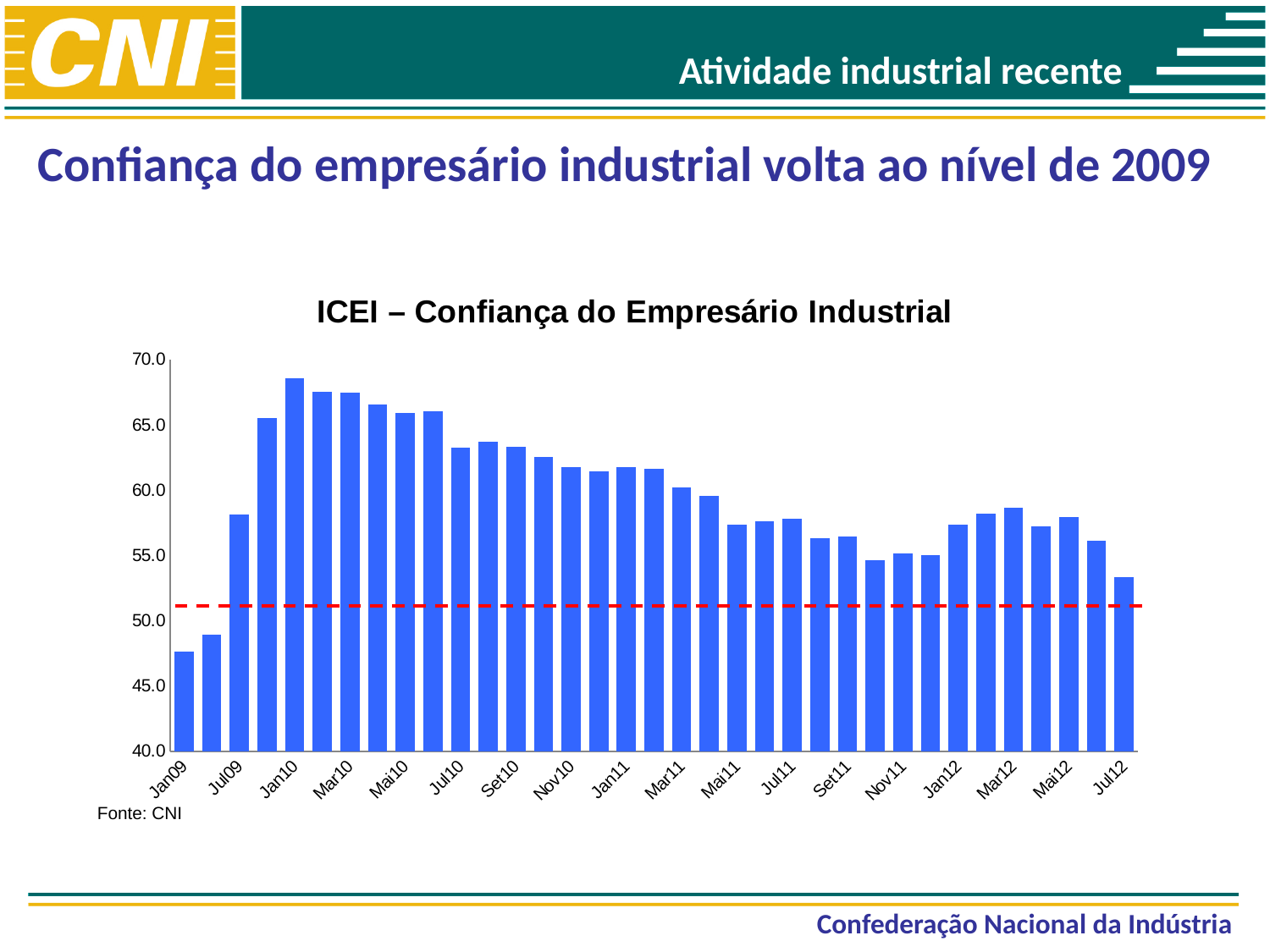
Which is larger, the value for Mar10 or the value for Mar12? Mar10 What kind of chart is shown on the slide? bar chart Is the value for Jan09 greater or less than 50? less Which labeled period on the x axis has the lowest bar? Jan09 What source is cited below the chart? CNI Is the value for Jul12 greater or less than 55? less Is the value for Set11 greater or less than 55? greater Do the values generally rise or fall from Jan10 to Jul12? fall What is the title of the chart? ICEI – Confiança do Empresário Industrial Which is larger, the value for Jan10 or the value for Jul12? Jan10